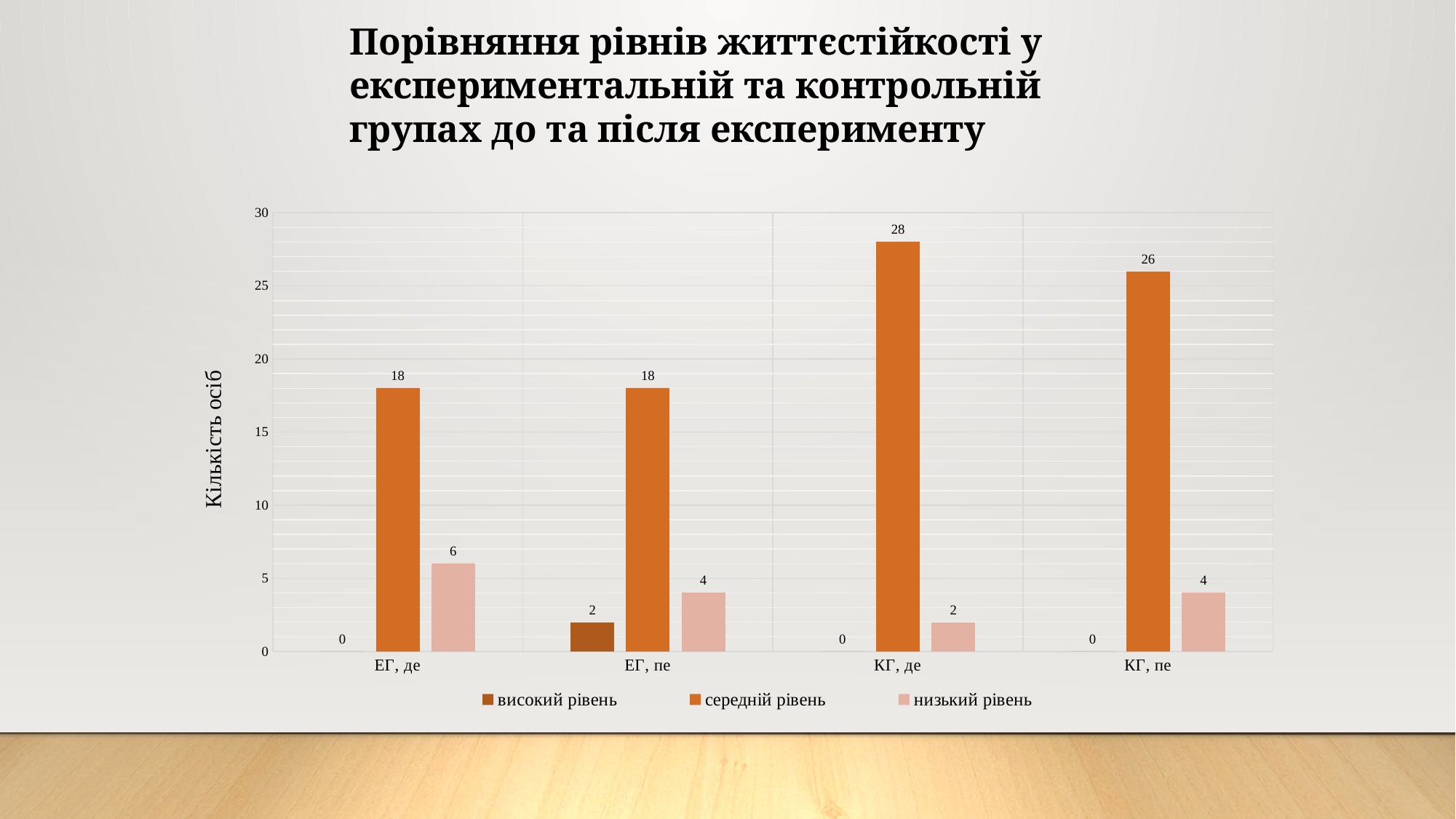
What is the value for середній рівень in the КГ, де category? 28 What is the difference between the середній рівень values for КГ, де and КГ, пе? 2 Which is larger: низький рівень for ЕГ, де or низький рівень for ЕГ, пе? ЕГ, де What kind of chart is shown on the slide? bar chart What is the label of the vertical axis? Кількість осіб Which category has the lowest value for низький рівень? КГ, де Which category has the highest value for середній рівень? КГ, де What is the value for низький рівень in the ЕГ, де category? 6 What is the value for низький рівень in the КГ, пе category? 4 How many series does the legend list? 3 What is the value for високий рівень in the ЕГ, пе category? 2 How many categories are shown on the x axis? 4